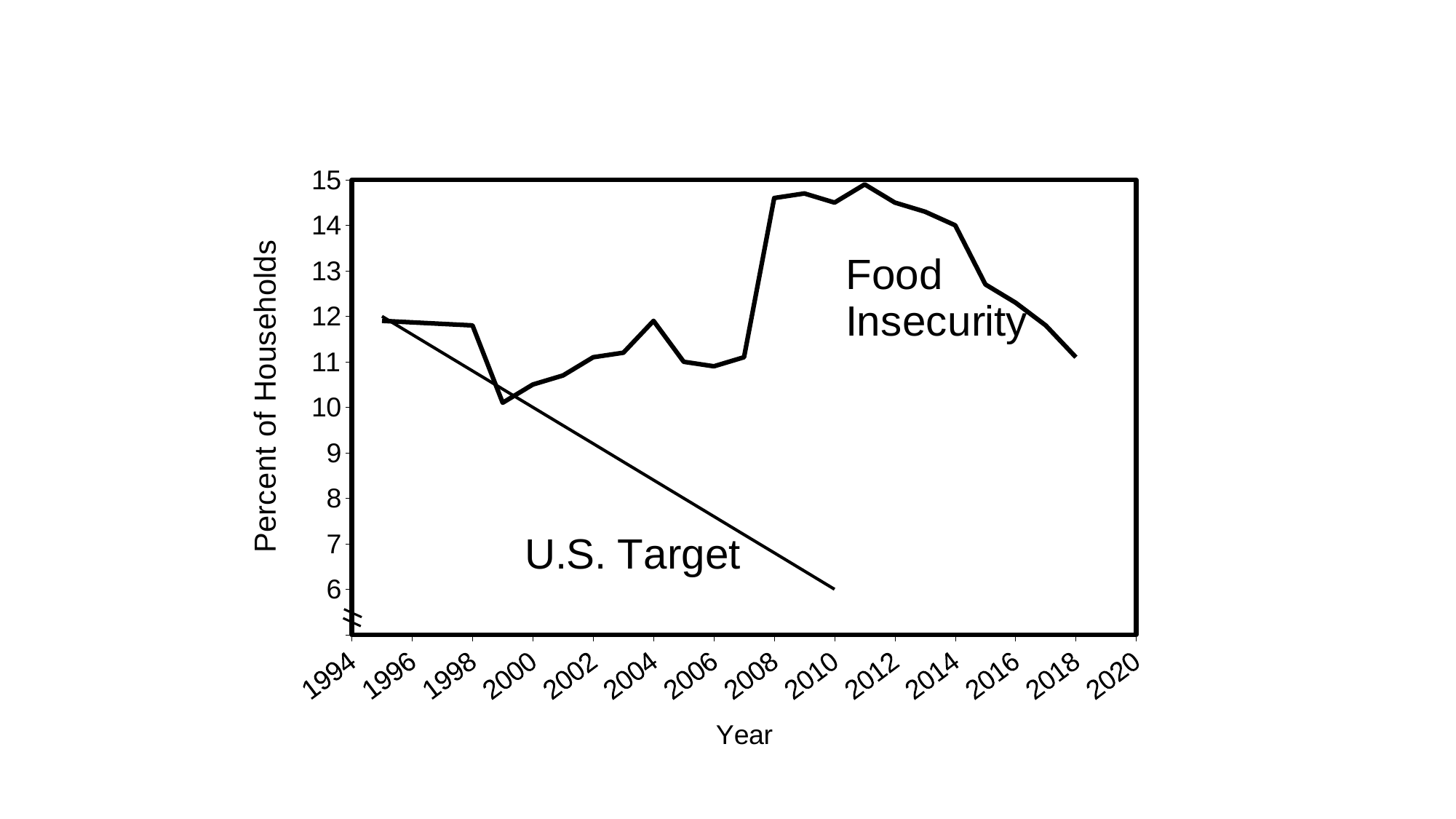
Is the Food Insecurity value in 2008 greater or less than 14? greater What kind of chart is shown on the slide? line chart In 2008, which line has the higher value, Food Insecurity or U.S. Target? Food Insecurity Does the U.S. Target line rise or fall from 1995 to 2010? fall Does the Food Insecurity line rise or fall from 2011 to 2018? fall Is the Food Insecurity value in 1999 greater or less than 11? less Is the Food Insecurity value higher in 2007 or in 2008? 2008 What is the title of the y axis? Percent of Households How many lines are plotted on the chart? 2 What is the title of the x axis? Year Is the U.S. Target value in 2006 greater or less than 9? less